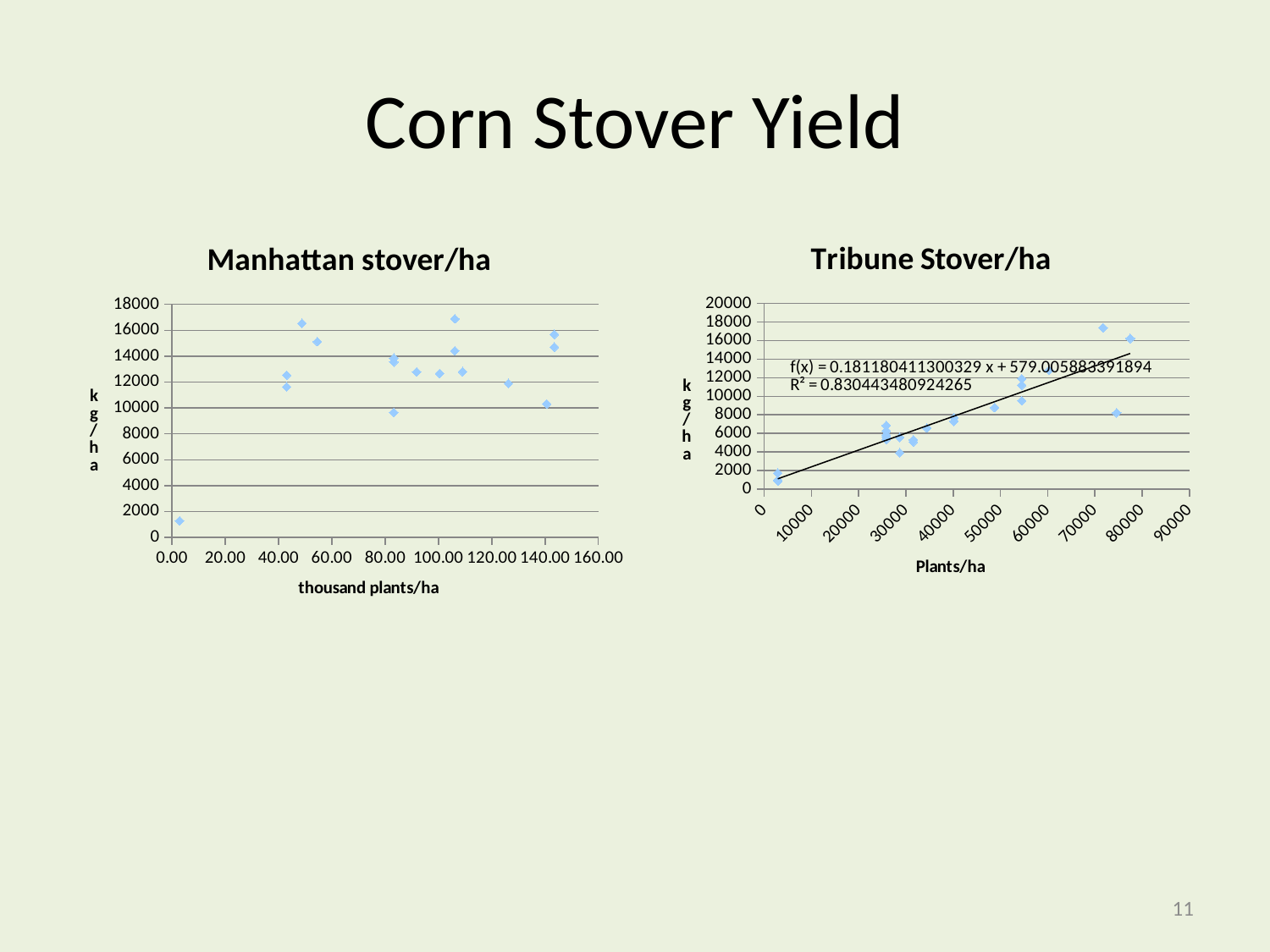
In the Manhattan stover/ha chart, is the lowest point near 80 thousand plants/ha greater or less than 10000? less In the Manhattan stover/ha chart, is the highest plotted point greater or less than 16000? greater In the Tribune Stover/ha chart, is the highest plotted point greater or less than 16000? greater What is the x-axis title of the Manhattan stover/ha chart? thousand plants/ha In the Tribune Stover/ha chart, what R² value is printed for the trendline? R² = 0.830443480924265 What kind of chart is the Tribune Stover/ha chart? scatter chart In the Tribune Stover/ha chart, do the stover values generally rise or fall as plants/ha increases? rise What kind of chart is the Manhattan stover/ha chart? scatter chart